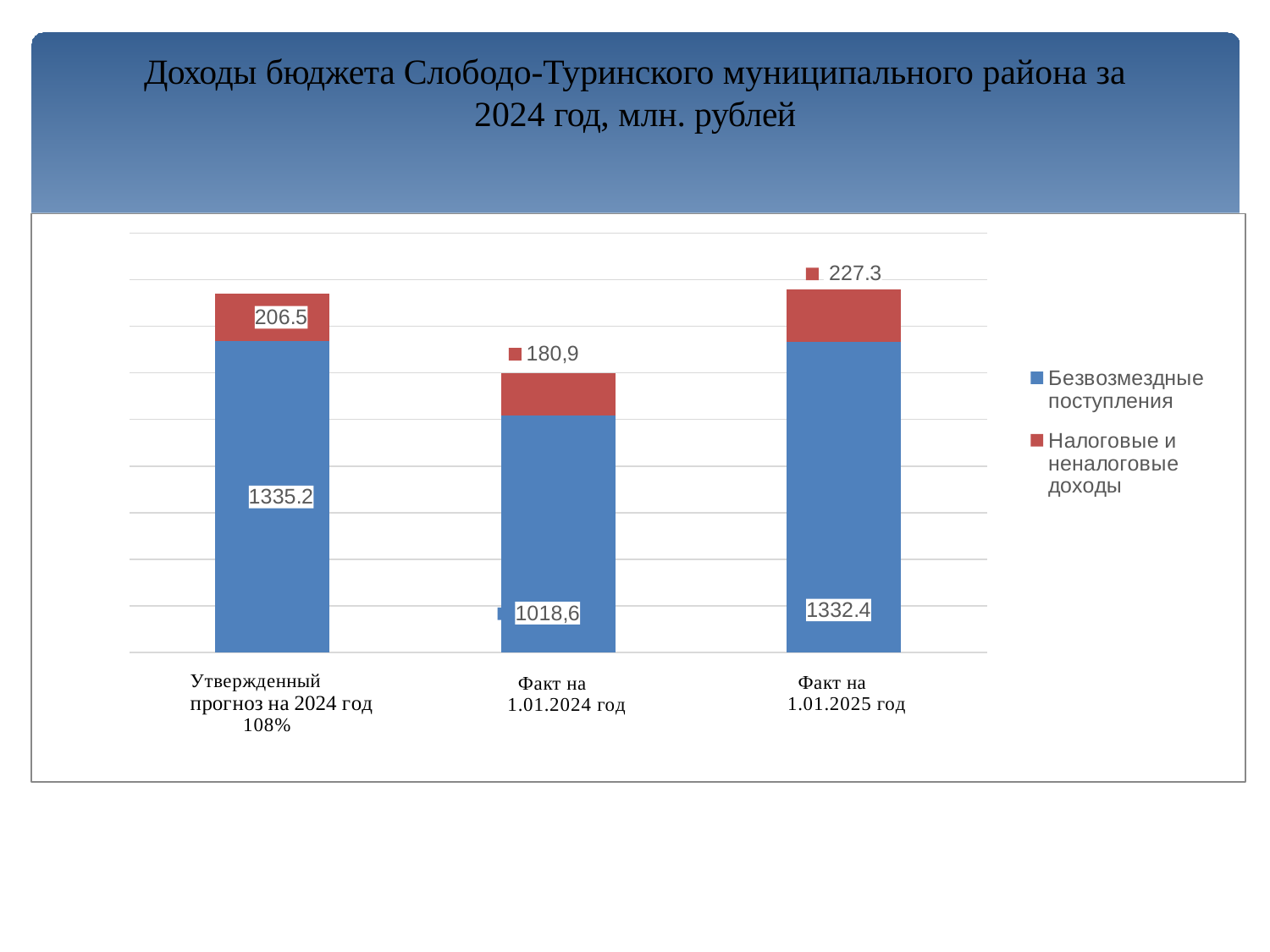
What is the total of the stacked bar for Факт на 1.01.2024 год? 1199.5 Which category has the highest value for Налоговые и неналоговые доходы? Факт на 1.01.2025 год How many categories are shown on the x axis? 3 What is the value of Безвозмездные поступления for Утвержденный прогноз на 2024 год? 1335.2 What is the value of Налоговые и неналоговые доходы for Факт на 1.01.2025 год? 227.3 What is the value of Налоговые и неналоговые доходы for Факт на 1.01.2024 год? 180,9 Which category has the lowest value for Безвозмездные поступления? Факт на 1.01.2024 год How many series does the legend list? 2 What type of chart is shown on the slide? stacked bar chart What is the value of Безвозмездные поступления for Факт на 1.01.2025 год? 1332.4 What is the difference between Налоговые и неналоговые доходы for Факт на 1.01.2025 год and Факт на 1.01.2024 год? 46.4 Which colour represents Безвозмездные поступления in the chart? blue